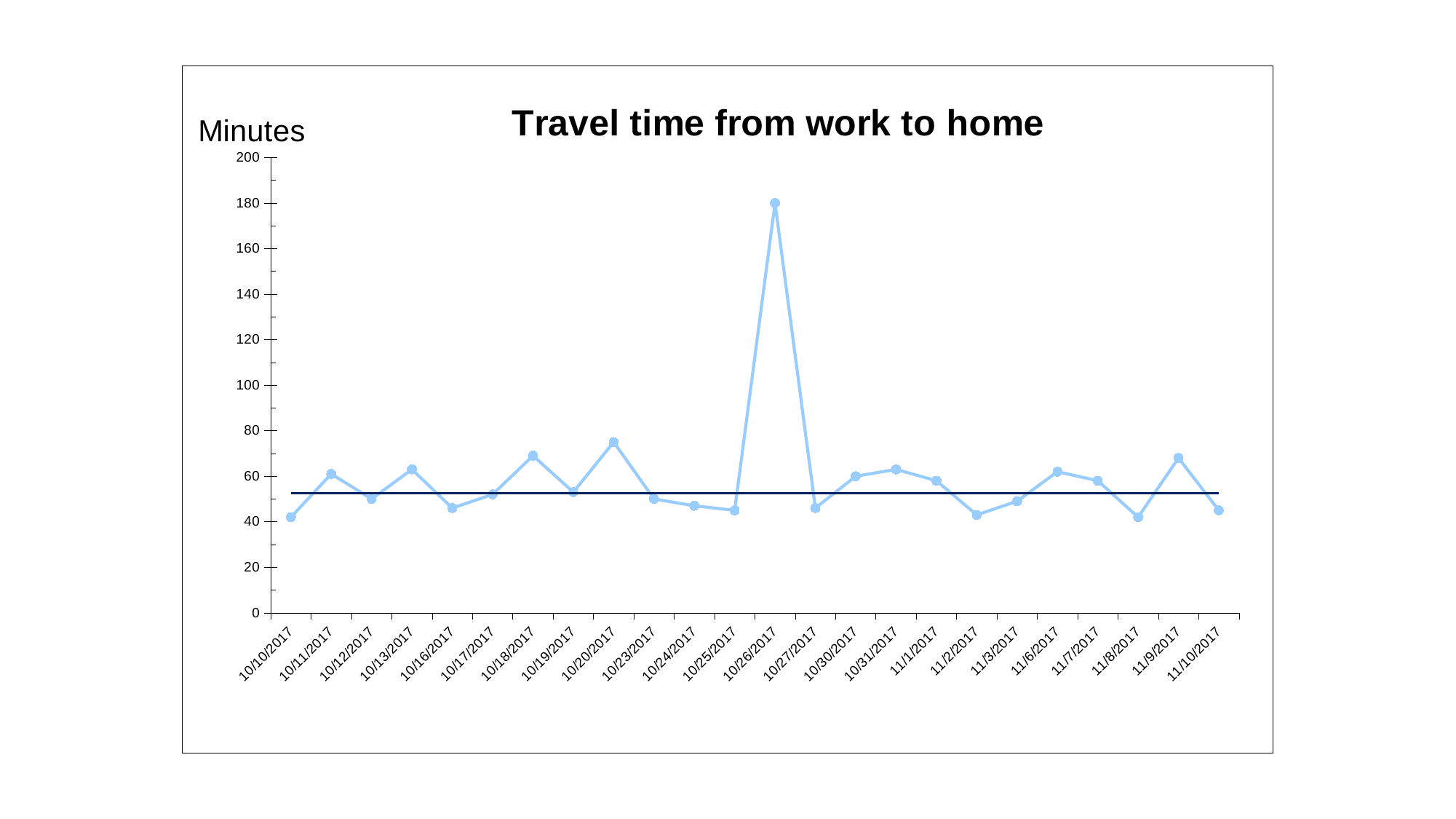
What kind of chart is shown on the slide? line chart Which has the larger travel time, 10/26/2017 or 10/27/2017? 10/26/2017 What label is shown on the vertical axis of the chart? Minutes Which has the larger travel time, 10/20/2017 or 10/10/2017? 10/20/2017 How many dates are plotted on the x axis? 24 Is the value for 10/20/2017 greater or less than 60? greater Is the value for 10/10/2017 greater or less than 60? less Is the value for 10/26/2017 greater or less than 160? greater What is the title of the chart? Travel time from work to home Which date has the highest travel time? 10/26/2017 What is the travel time in minutes on 10/26/2017? 180